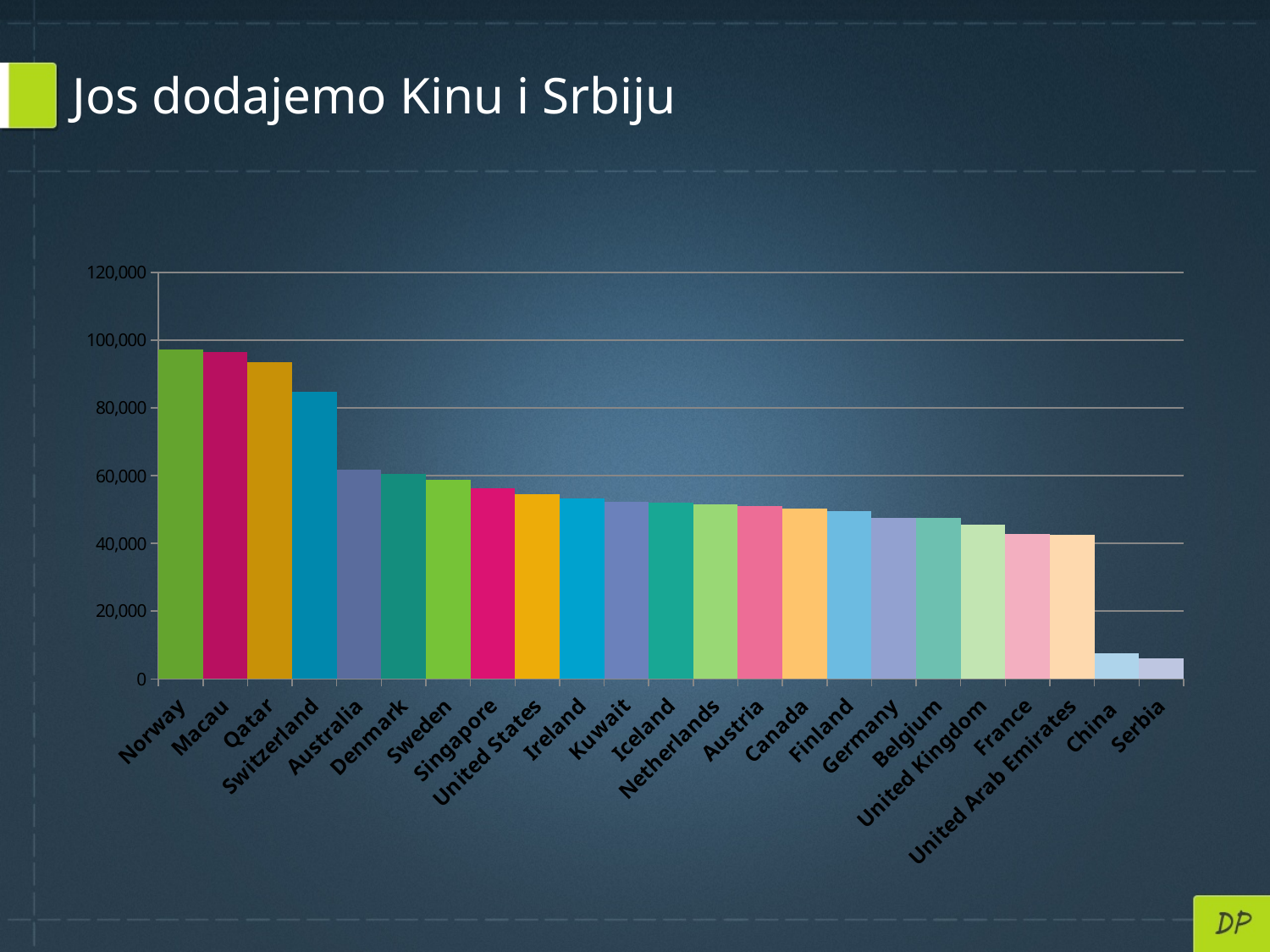
Do the values generally rise or fall moving from left to right along the x axis? fall Is the value for France greater or less than 60,000? less Is the value for Denmark greater or less than 40,000? greater Is the value for Norway greater or less than 80,000? greater What is the title of the slide? Jos dodajemo Kinu i Srbiju Which has the larger value, Switzerland or Australia? Switzerland Which has the larger value, Qatar or Sweden? Qatar What kind of chart is shown on the slide? bar chart How many countries are shown on the x axis of the chart? 23